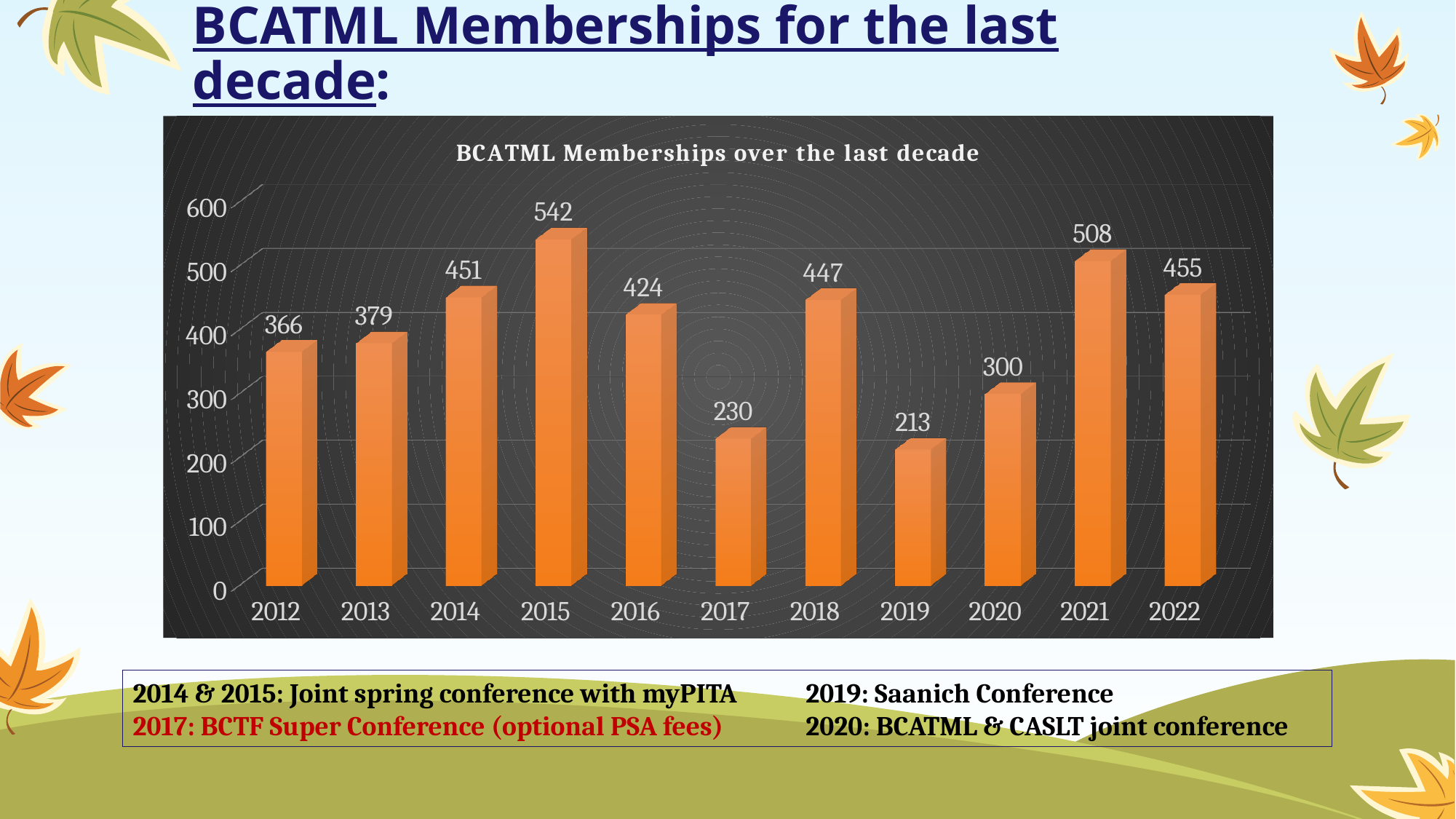
Do the membership values rise or fall from 2019 to 2021? Rise Which year has the highest membership? 2015 Is the value for 2017 greater or less than 300? less What is the BCATML membership value for 2015? 542 How many years are shown on the x axis of the chart? 11 What is the difference between the 2021 and 2020 membership values? 208 Which year has a larger membership value, 2014 or 2018? 2014 What is the title of the chart? BCATML Memberships over the last decade What kind of chart is shown on the slide? Bar chart What is the membership value shown for 2019? 213 Which year has the lowest membership? 2019 What is the membership value shown for 2022? 455